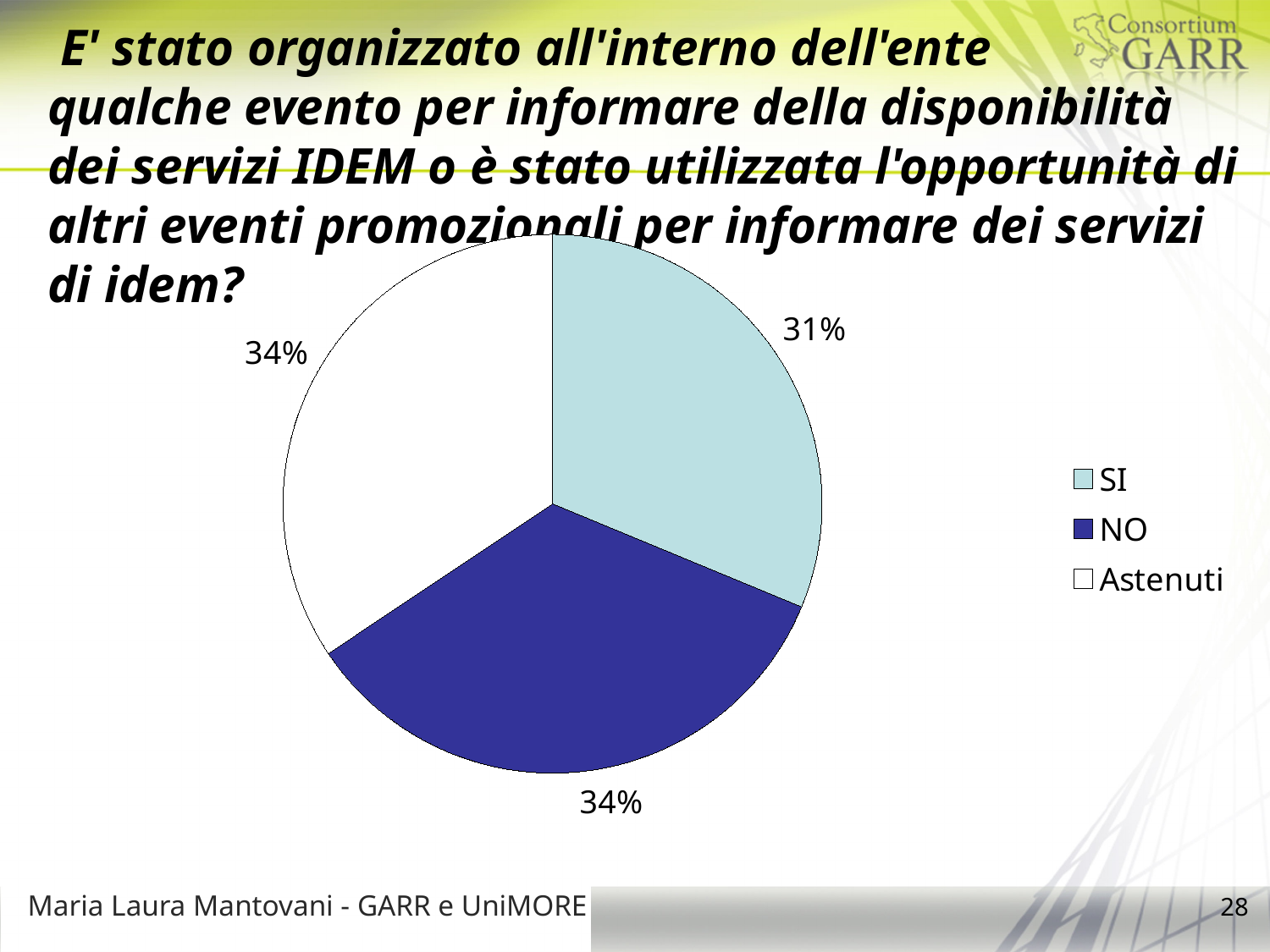
How many entries does the legend of the pie chart list? 3 Which slice is larger in the pie chart, NO or SI? NO By how many percentage points does the NO slice exceed the SI slice? 3 percentage points What percentage is shown for the Astenuti slice of the pie chart? 34% Which category has the smallest slice in the pie chart? SI What percentage is shown for the NO slice of the pie chart? 34% What percentage is shown for the SI slice of the pie chart? 31% What share of the pie does the SI slice represent? 31% How many slices does the pie chart have? 3 Which slice is larger in the pie chart, Astenuti or SI? Astenuti What are the three entries listed in the legend of the pie chart? SI, NO, Astenuti What kind of chart is shown on the slide? Pie chart